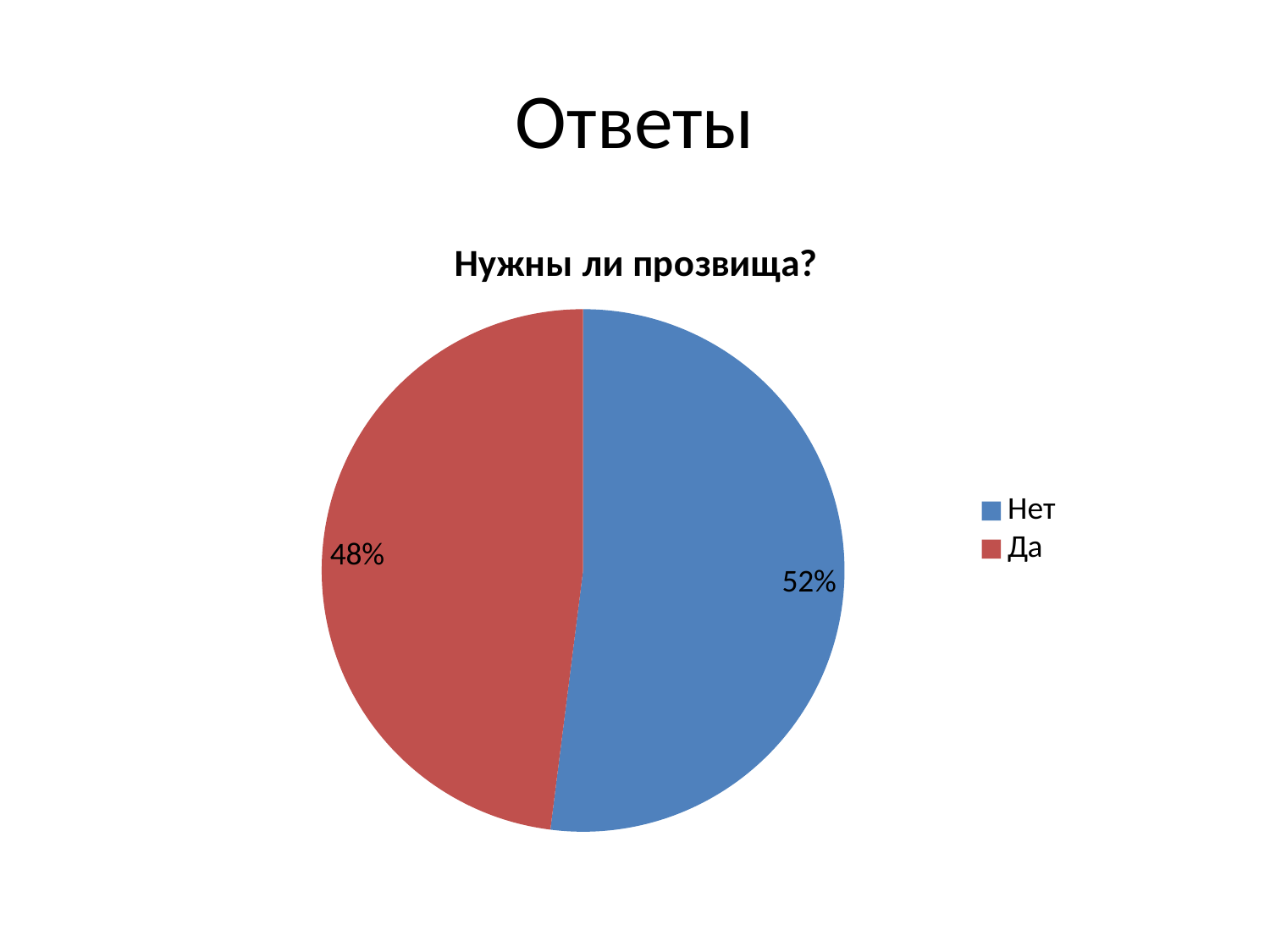
What is the difference between the "Нет" and "Да" shares? 4% How many slices does the pie chart have? 2 Which slice is the largest? Нет What colour is the "Да" slice? red What share of the pie is labelled "Нет"? 52% What is the chart's title? Нужны ли прозвища? What share of the pie is labelled "Да"? 48% Which is larger, the "Да" slice or the "Нет" slice? Нет Which slice is the smallest? Да What kind of chart is shown on the slide? pie chart How many entries does the legend list? 2